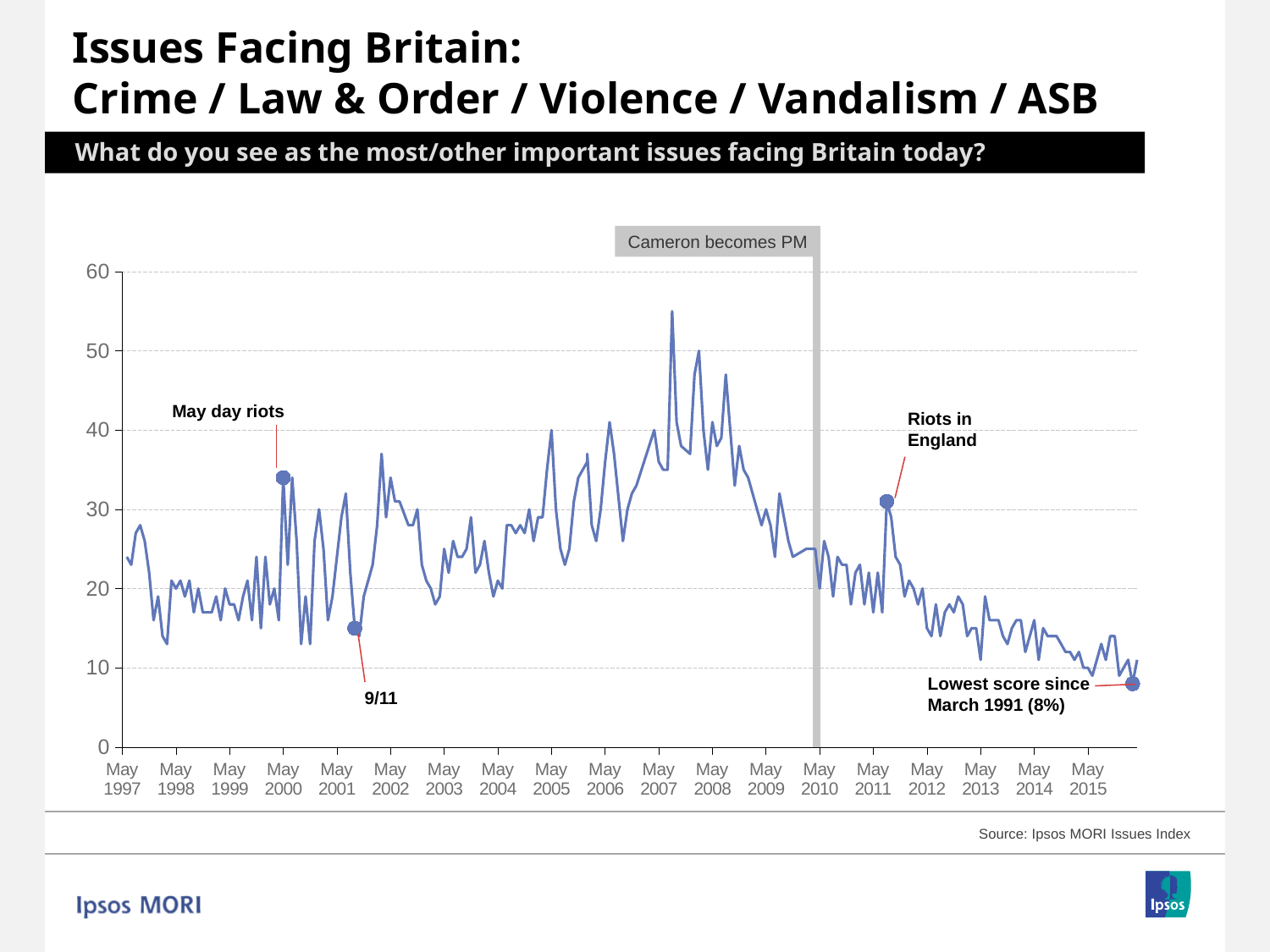
Is the value at the point labelled 'Riots in England' greater or less than 20? greater Which point has the larger value: 'May day riots' or '9/11'? May day riots How many highlighted dot markers are placed on the line? 4 What is the value marked as the lowest score since March 1991? 8% What event does the grey vertical band around 2010 mark? Cameron becomes PM Is the value at the point labelled 'May day riots' greater or less than 30? greater What is the source cited for the chart? Ipsos MORI Issues Index Does the line generally rise or fall between May 2008 and May 2015? fall Which point has the larger value: 'Riots in England' or '9/11'? Riots in England Is the value at the point labelled '9/11' greater or less than 20? less What kind of chart is shown on the slide? line chart